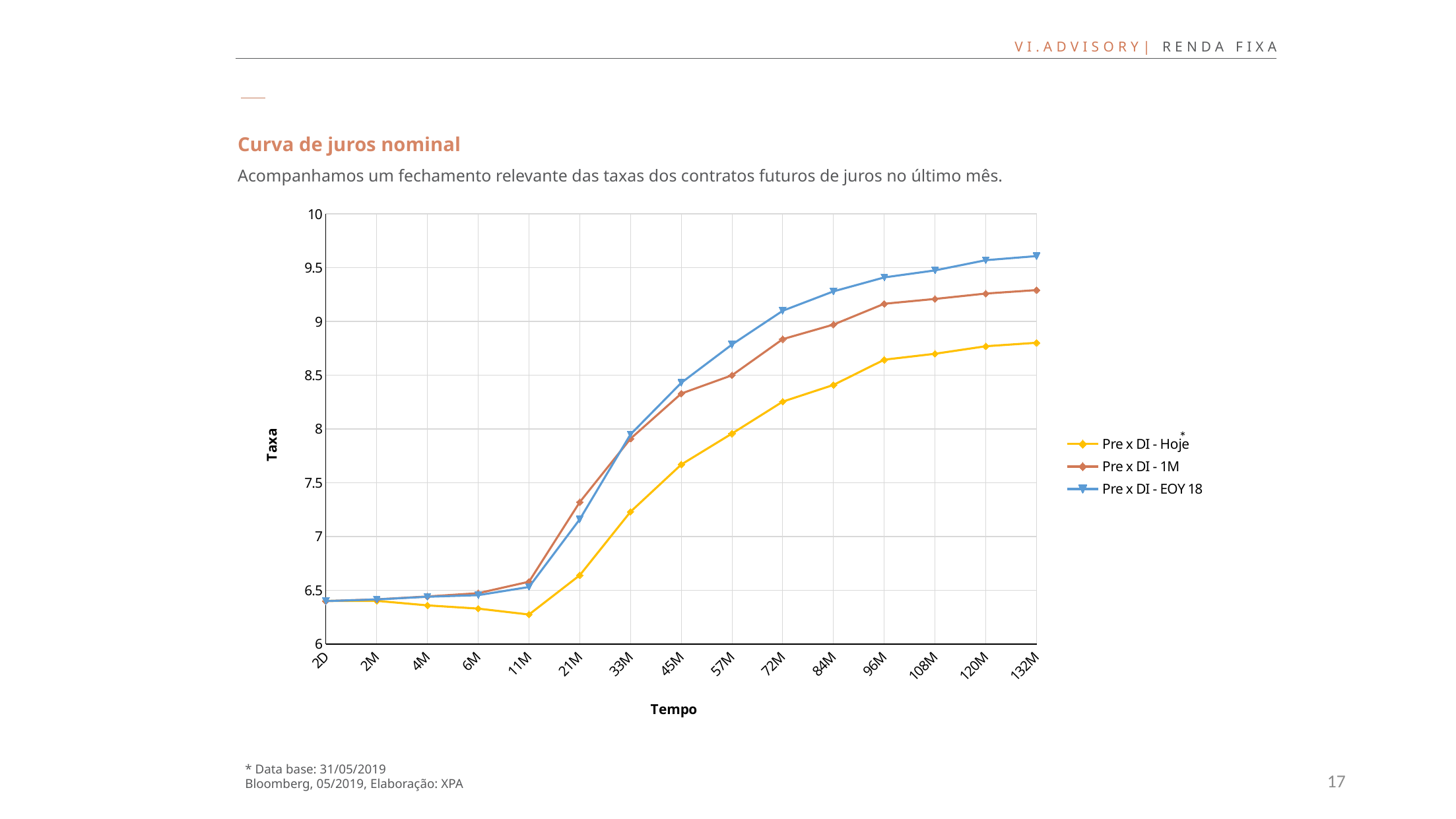
How many series does the legend list? 3 At 132M, which series has the higher value, Pre x DI - Hoje or Pre x DI - EOY 18? Pre x DI - EOY 18 What kind of chart is shown on the slide? Line chart What is the label of the vertical axis? Taxa Is the value for Pre x DI - EOY 18 at 132M greater or less than 9.5? greater Does the Pre x DI - EOY 18 series generally rise or fall from 2D to 132M? Rise Is the value for Pre x DI - 1M at 21M greater or less than 7? greater Is the value for Pre x DI - Hoje at 132M greater or less than 9? less What is the title of the chart? Curva de juros nominal How many categories are shown on the x axis? 15 At which category does the Pre x DI - Hoje series reach its lowest value? 11M